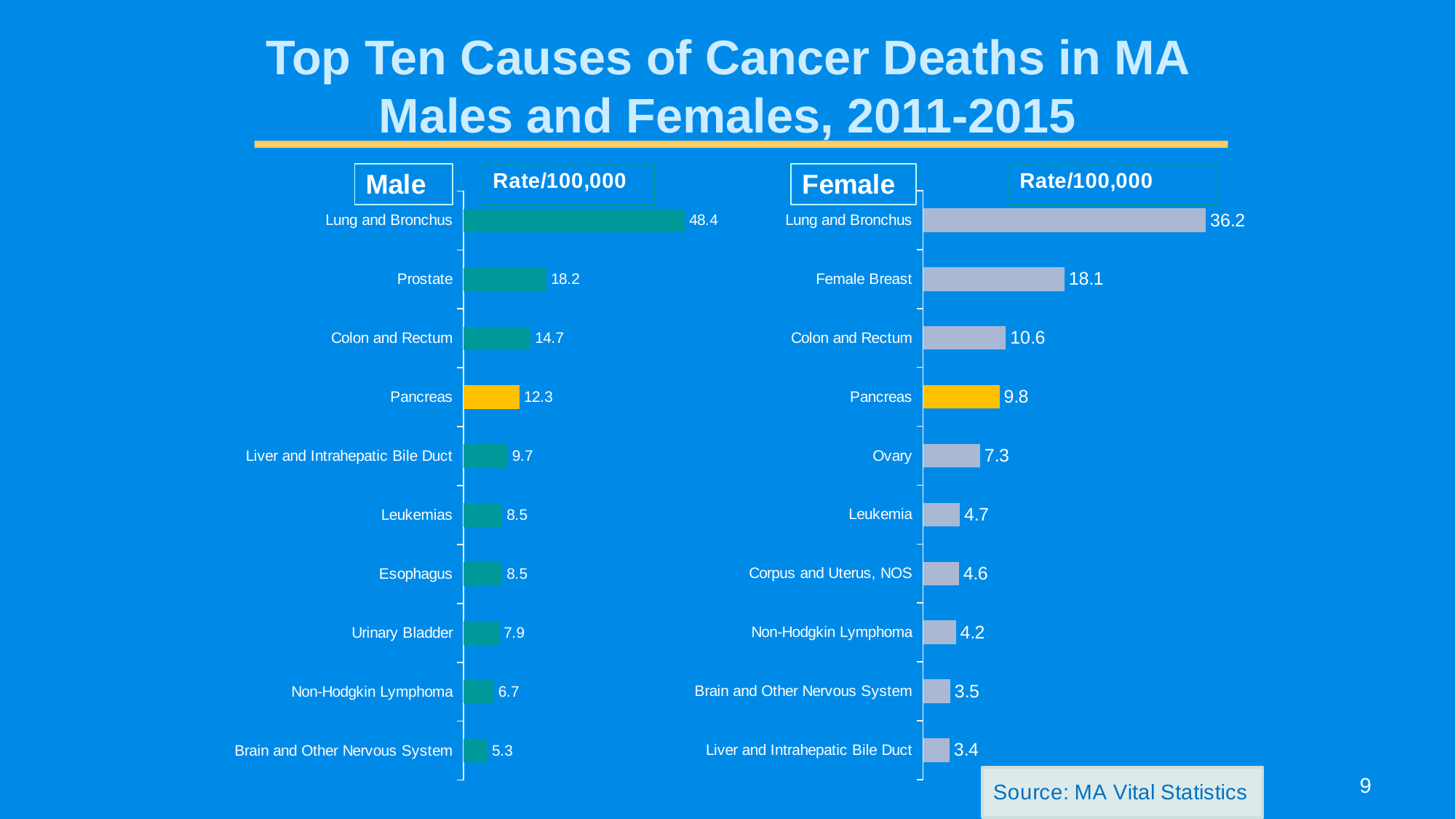
In the Female chart, which cause has the highest rate? Lung and Bronchus In the Female chart, which cause has the lowest rate? Liver and Intrahepatic Bile Duct In the Male chart, what is the difference between the Lung and Bronchus rate and the Prostate rate? 30.2 What kind of chart is the Male chart? Bar chart How many causes are listed in the Female chart? 10 In the Female chart, what is the rate per 100,000 for Female Breast? 18.1 In the Male chart, what is the rate per 100,000 for Lung and Bronchus? 48.4 In the Male chart, which cause has the lowest rate? Brain and Other Nervous System In the Male chart, which bar is coloured yellow instead of green? Pancreas Which is larger: the Pancreas rate in the Male chart or the Pancreas rate in the Female chart? Male chart In the Male chart, what is the difference between the Prostate rate and the Colon and Rectum rate? 3.5 In the Female chart, what is the rate per 100,000 for Non-Hodgkin Lymphoma? 4.2